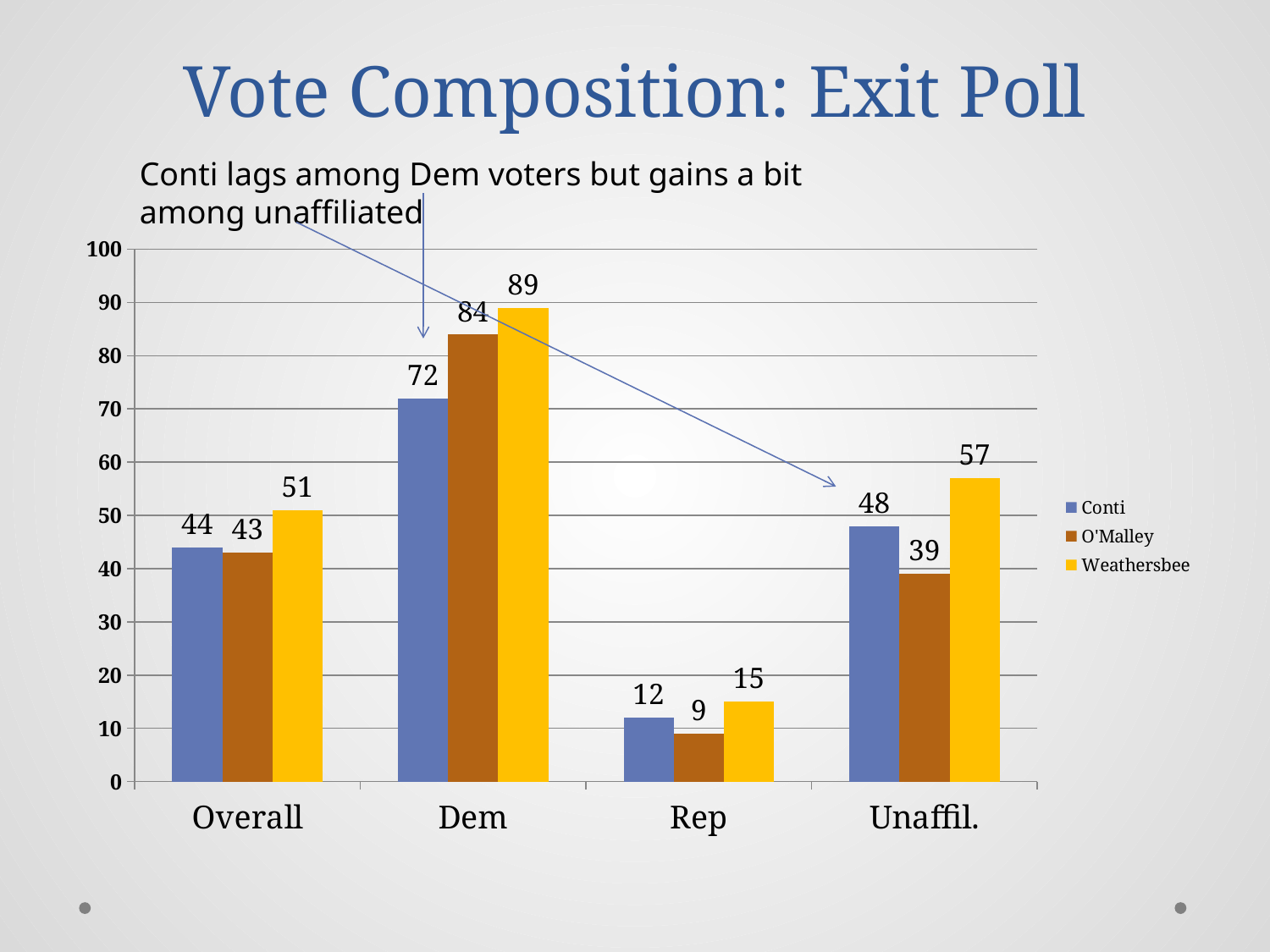
Which category has the highest value for Weathersbee? Dem Which series is shown in yellow in the legend? Weathersbee Which category has the lowest value for Conti? Rep What is the difference between Weathersbee and Conti in the Dem category? 17 How many series does the legend list? 3 Is the value for O'Malley in the Dem category greater or less than 80? greater What kind of chart is shown on the slide? bar chart What is the value for Weathersbee in the Unaffil. category? 57 What is the value for Conti in the Dem category? 72 How many categories are shown on the x axis? 4 What is the value for O'Malley in the Rep category? 9 Which is larger in the Unaffil. category, Conti or O'Malley? Conti